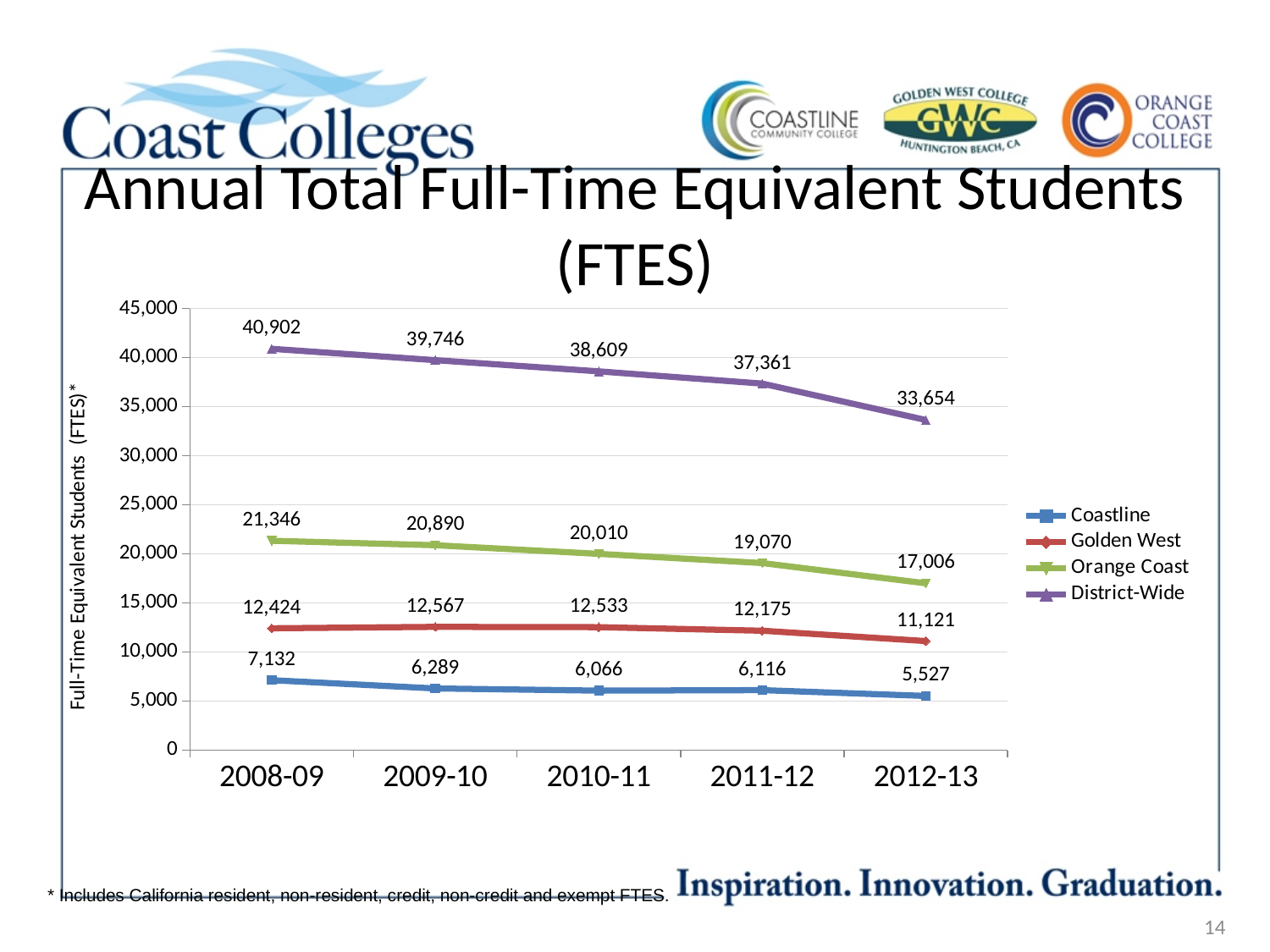
What is the District-Wide FTES value for 2012-13? 33,654 In which year is the Coastline FTES value lowest? 2012-13 How many academic years are shown on the x axis? 5 How many series does the legend list? 4 Does the District-Wide FTES value rise or fall from 2008-09 to 2012-13? fall What is the Coastline FTES value for 2008-09? 7,132 Is the Orange Coast value for 2012-13 greater or less than 20,000? less What kind of chart is shown on the slide? line chart What is the difference between the District-Wide FTES values for 2008-09 and 2012-13? 7,248 What is the Orange Coast FTES value for 2010-11? 20,010 Which is larger, the Orange Coast value for 2011-12 or the Golden West value for 2011-12? Orange Coast In which year is the Golden West FTES value highest? 2009-10